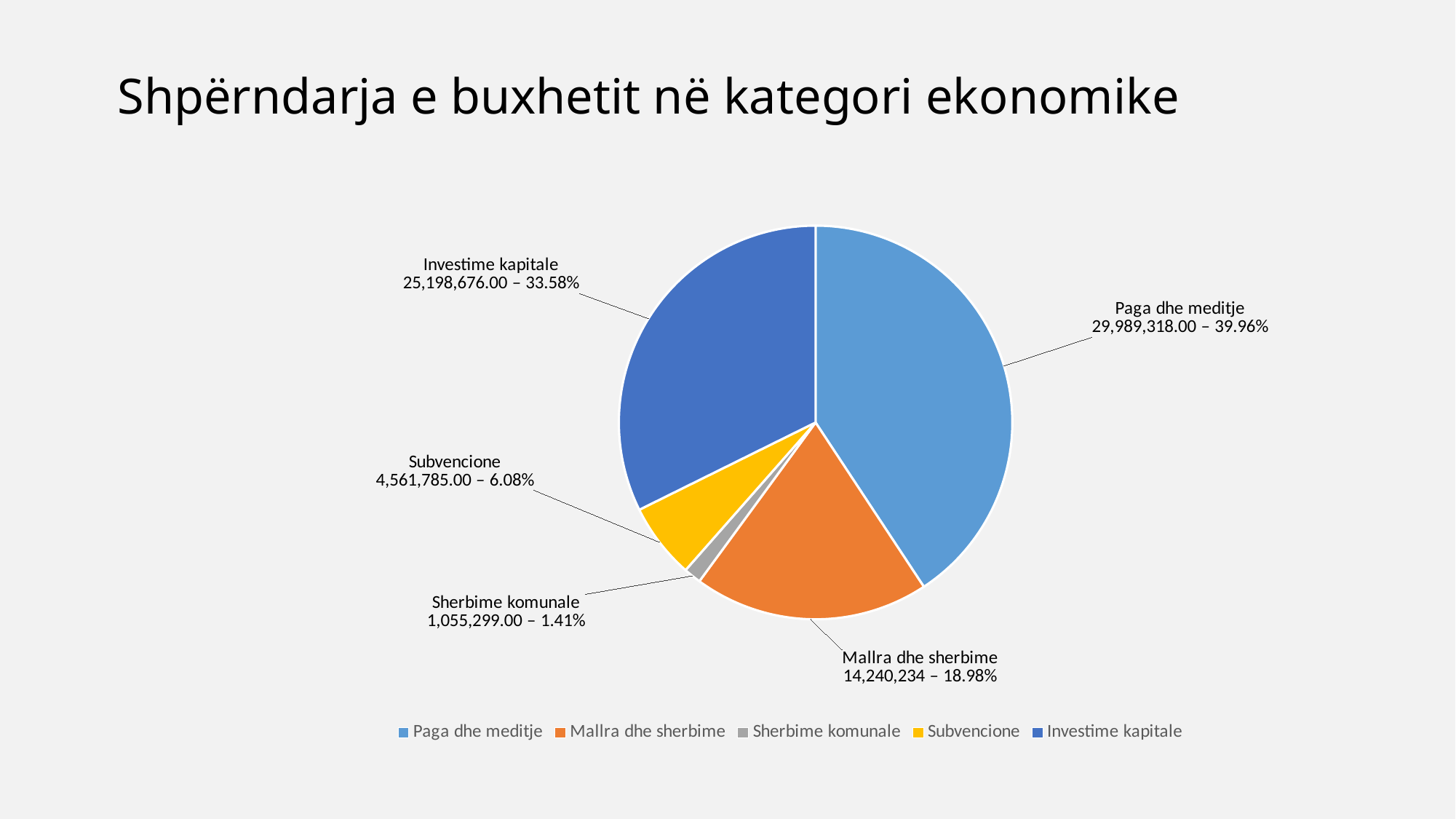
What is the value shown for Sherbime komunale? 1,055,299.00 Which category has the smallest share of the pie? Sherbime komunale What kind of chart is shown on the slide? pie chart Which category has the largest share of the pie? Paga dhe meditje What percentage share does Investime kapitale have? 33.58% What is the title of the chart on the slide? Shpërndarja e buxhetit në kategori ekonomike What colour is the Subvencione slice? yellow What is the difference in percentage share between Paga dhe meditje and Investime kapitale? 6.38% What is the value shown for Paga dhe meditje? 29,989,318.00 How many entries does the legend list? 5 How many slices does the pie chart have? 5 Which is larger, the share for Subvencione or the share for Mallra dhe sherbime? Mallra dhe sherbime